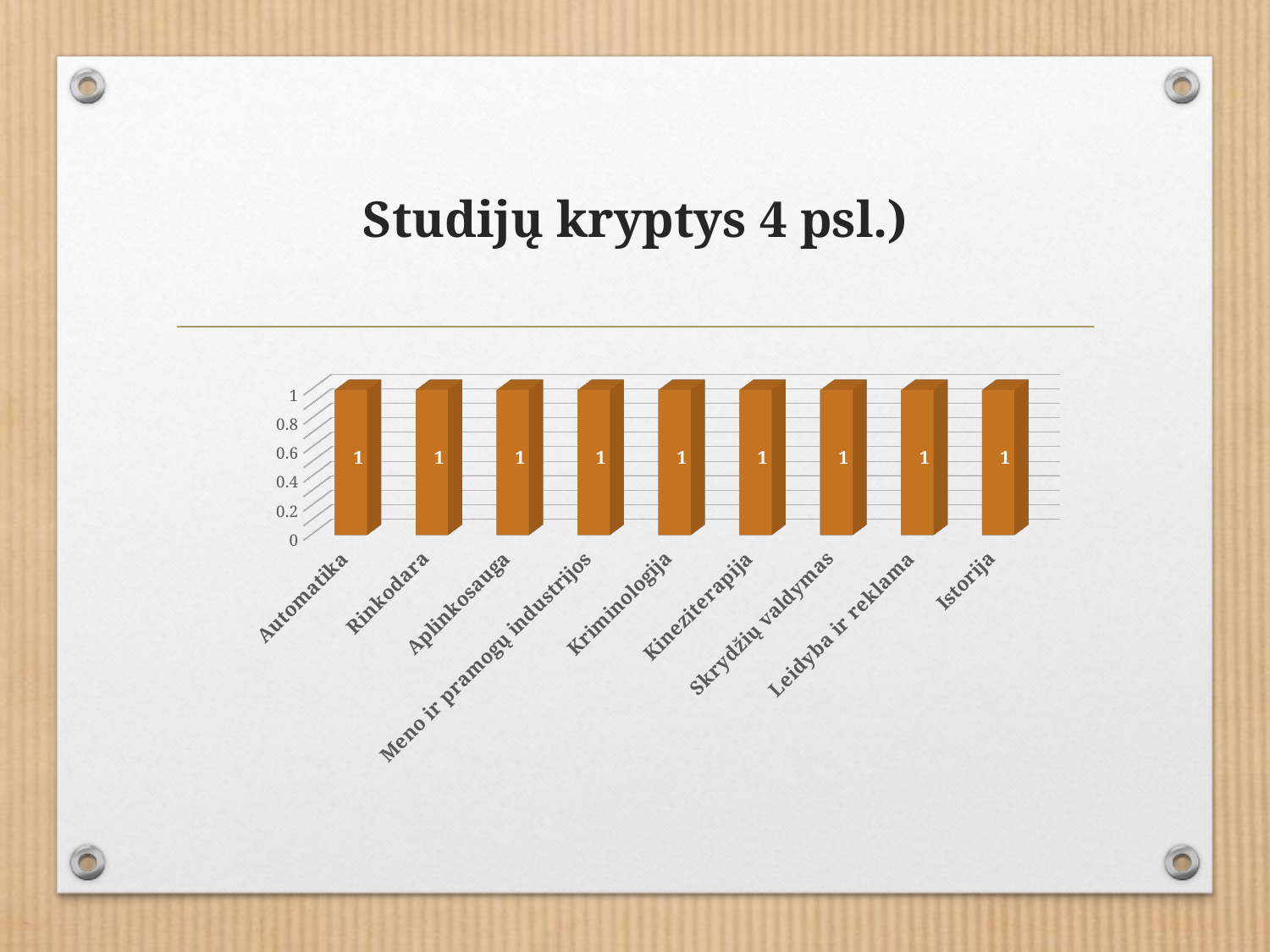
What is the highest value shown on the y axis? 1 What is the value for Kriminologija? 1 What colour are the bars in the chart? orange How many categories are shown on the x axis? 9 Do the values rise, fall or stay the same across the categories from left to right? stay the same What is the title of the chart slide? Studijų kryptys 4 psl.) What is the value for Automatika? 1 What is the difference between the values for Rinkodara and Aplinkosauga? 0 Is the value for Kineziterapija greater or less than 0.5? greater What is the value for Istorija? 1 What kind of chart is shown on the slide? bar chart What is the value for Skrydžių valdymas? 1